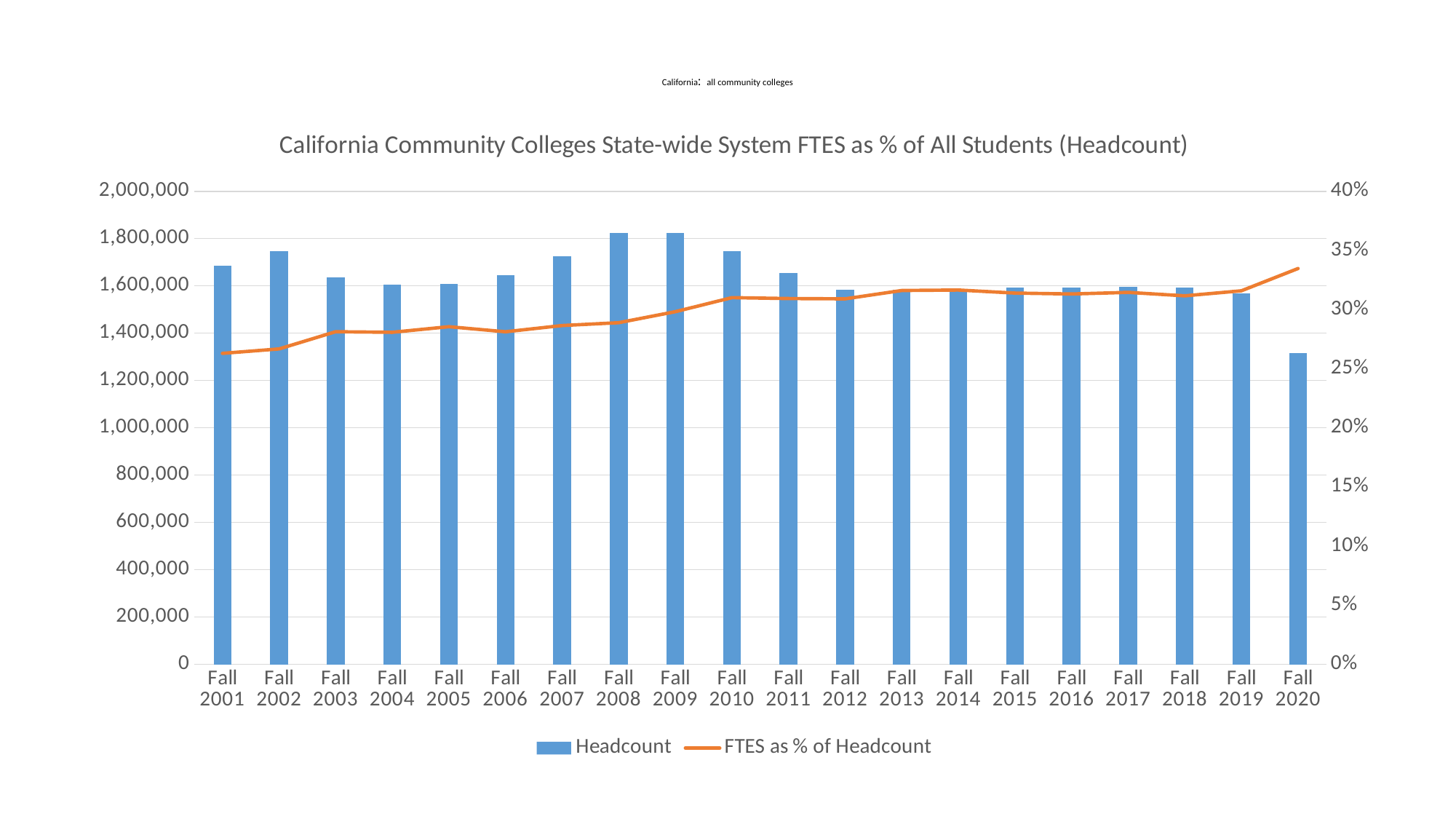
In which Fall term is FTES as % of Headcount highest? Fall 2020 How many series does the legend list? 2 How many Fall terms are shown on the x axis? 20 What is the title of the chart? California Community Colleges State-wide System FTES as % of All Students (Headcount) Which has the larger Headcount, Fall 2002 or Fall 2004? Fall 2002 Is FTES as % of Headcount for Fall 2001 greater or less than 30%? less Is FTES as % of Headcount for Fall 2020 greater or less than 30%? greater Is the Headcount for Fall 2001 greater or less than 1,600,000? greater What kind of chart is shown on the slide? A combination bar and line chart Does FTES as % of Headcount generally rise or fall from Fall 2001 to Fall 2020? rise Which Fall term has the lowest Headcount? Fall 2020